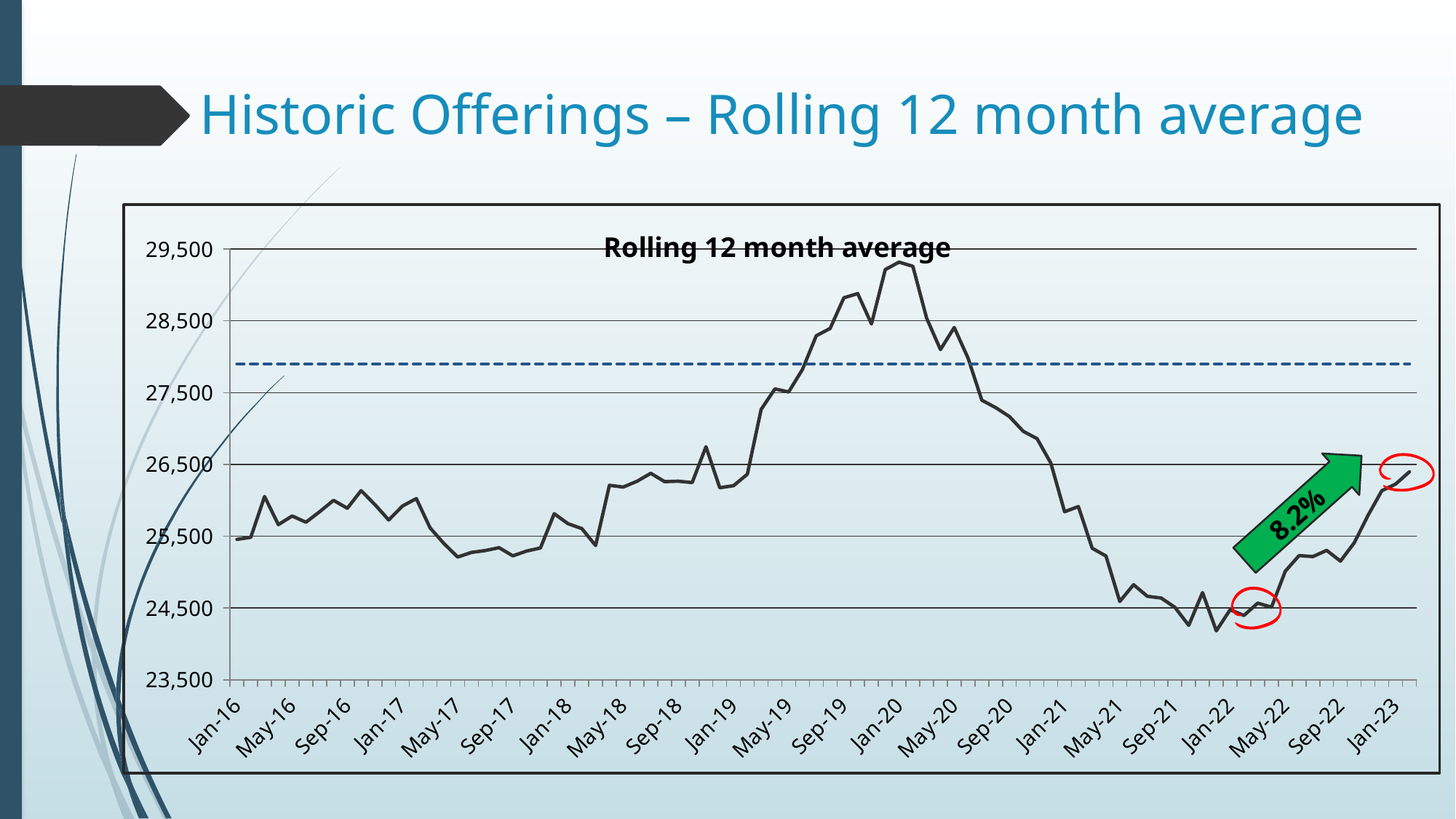
Does the line rise or fall between Jan-20 and Sep-21? fall What is the title of the chart? Rolling 12 month average Is the value for Jan-20 greater or less than 28,500? greater Among the months labelled on the x axis, which has the highest value? Jan-20 Is the value for May-21 greater or less than 25,500? less Which is larger, the value for Jan-20 or the value for Jan-16? Jan-20 What kind of chart is shown on the slide? line chart Which is larger, the value for Jan-19 or the value for Jan-22? Jan-19 Is the value for Jan-22 greater or less than 25,500? less What percentage is written on the green arrow annotation on the chart? 8.2%